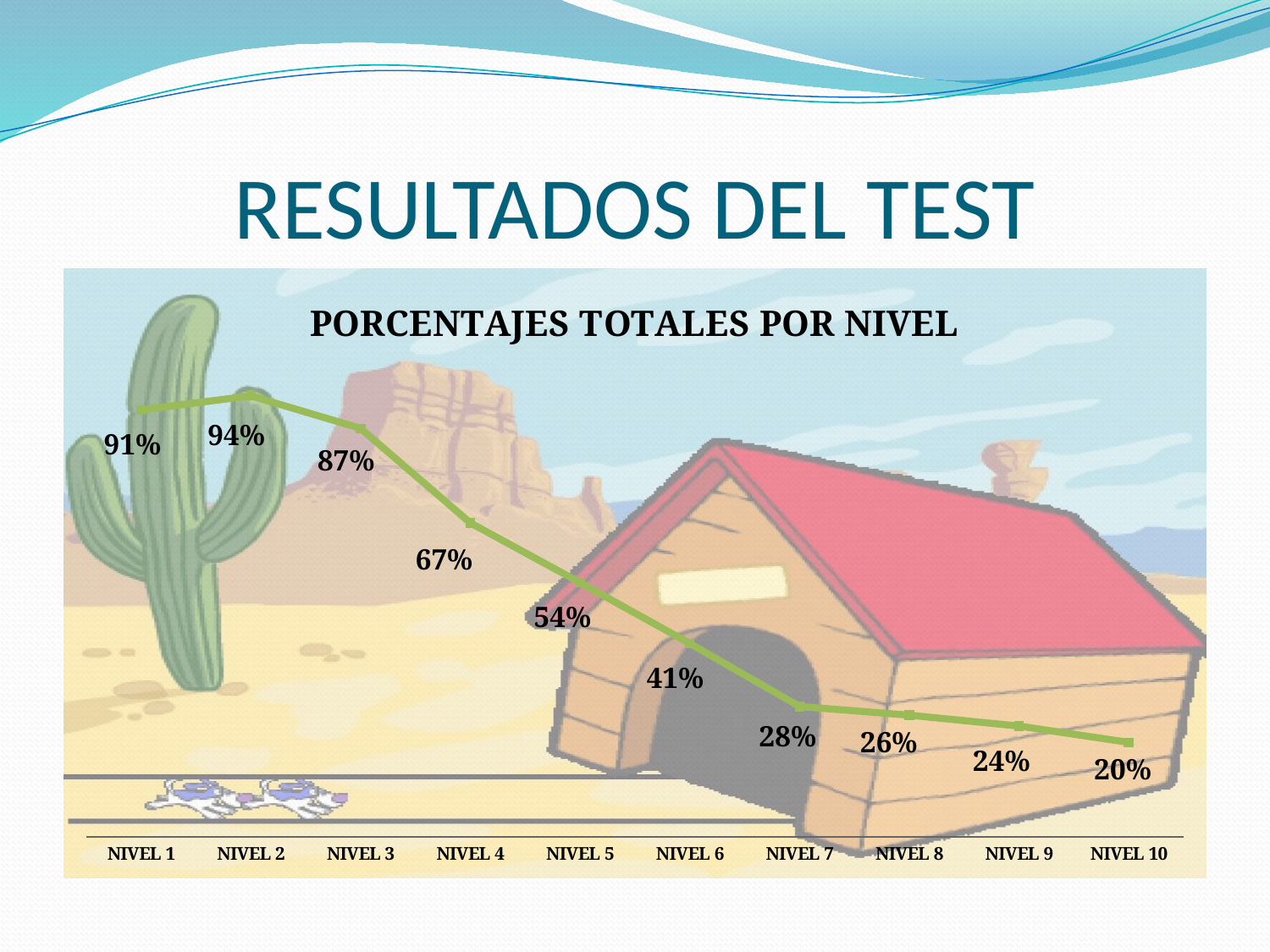
What kind of chart is shown? line chart What is the title of the chart? PORCENTAJES TOTALES POR NIVEL Do the values rise or fall from NIVEL 2 to NIVEL 10? fall Which is larger, the value for NIVEL 6 or the value for NIVEL 7? NIVEL 6 Which level has the highest value? NIVEL 2 Which level has the lowest value? NIVEL 10 What is the difference between the values for NIVEL 2 and NIVEL 10? 74% What is the value for NIVEL 1? 91% What is the value for NIVEL 5? 54% What is the value for NIVEL 10? 20% What is the difference between the values for NIVEL 3 and NIVEL 4? 20% How many levels are plotted on the x axis? 10